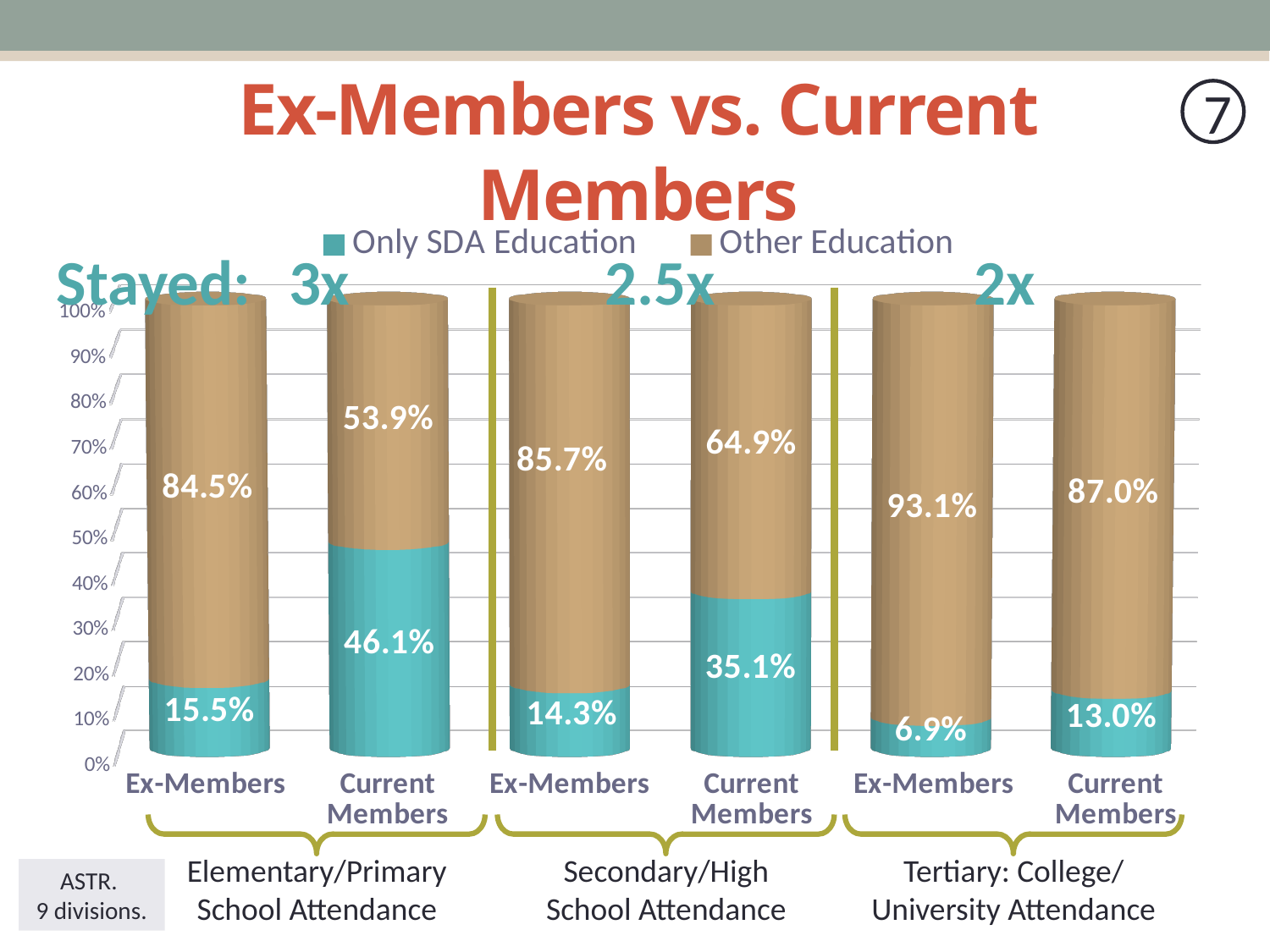
What is the total of the Ex-Members bar in the Tertiary: College/University Attendance group? 100% What kind of chart is shown on the slide? Stacked bar chart Which bar has the highest Only SDA Education value? Current Members (Elementary/Primary School Attendance) What is the Only SDA Education value for Current Members in the Elementary/Primary School Attendance group? 46.1% How many series does the legend list? 2 What is the difference between the Only SDA Education values for Current Members and Ex-Members in the Secondary/High School Attendance group? 20.8% What is the Other Education value for Ex-Members in the Tertiary: College/University Attendance group? 93.1% Which is larger: the Only SDA Education value for Current Members in the Tertiary group or for Ex-Members in the Elementary/Primary group? Ex-Members in the Elementary/Primary group What is the Other Education value for Current Members in the Secondary/High School Attendance group? 64.9% What is the Only SDA Education value for Ex-Members in the Secondary/High School Attendance group? 14.3% How many bars are plotted in the chart? 6 Which bar has the lowest Only SDA Education value? Ex-Members (Tertiary: College/University Attendance)